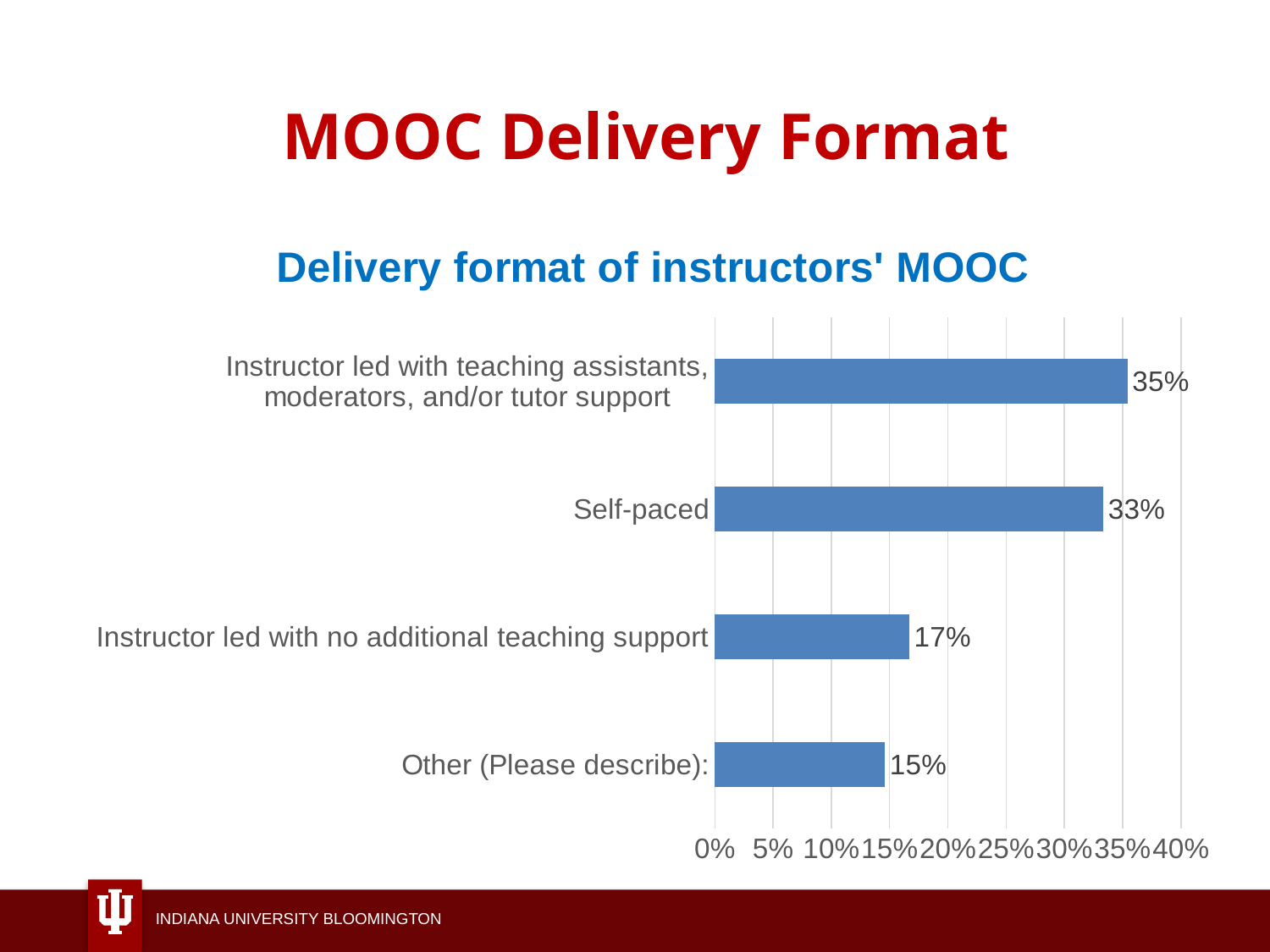
What is the value for 'Instructor led with teaching assistants, moderators, and/or tutor support'? 35% What is the value for 'Instructor led with no additional teaching support'? 17% What percentage of instructors' MOOCs are self-paced? 33% What is the value for 'Other (Please describe):'? 15% Which delivery format has the lowest percentage? Other (Please describe): Is the value for 'Instructor led with no additional teaching support' greater or less than 20%? less What is the difference between the 'Self-paced' value and the 'Instructor led with no additional teaching support' value? 16% Which delivery format has the highest percentage? Instructor led with teaching assistants, moderators, and/or tutor support What kind of chart is shown on the slide? Bar chart Which is larger: the value for 'Self-paced' or the value for 'Other (Please describe):'? Self-paced How many delivery format categories are shown in the chart? 4 What is the title of the chart? Delivery format of instructors' MOOC